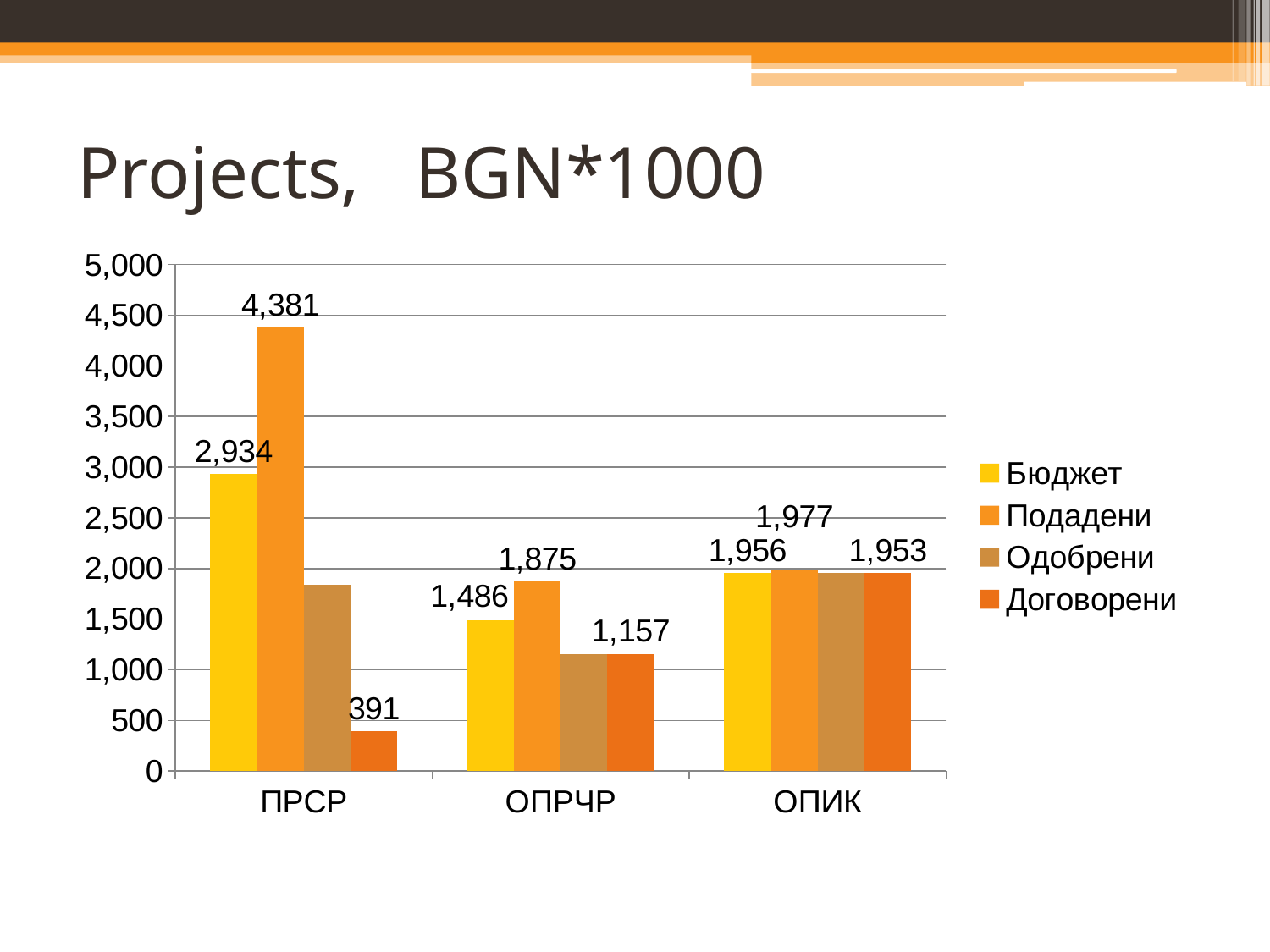
What is the title of the slide? Projects, BGN*1000 What is the value of Договорени for ПРСР? 391 Which is larger: Бюджет for ПРСР or Бюджет for ОПИК? Бюджет for ПРСР What is the value of Подадени for ПРСР? 4,381 Is the value of Одобрени for ПРСР greater or less than 1,500? greater What is the value of Бюджет for ПРСР? 2,934 How many series does the legend list? 4 What is the value of Подадени for ОПИК? 1,977 Which category has the highest Подадени value? ПРСР What is the value of Бюджет for ОПРЧР? 1,486 What is the difference between Подадени and Бюджет for ПРСР? 1,447 Which category has the lowest Договорени value? ПРСР